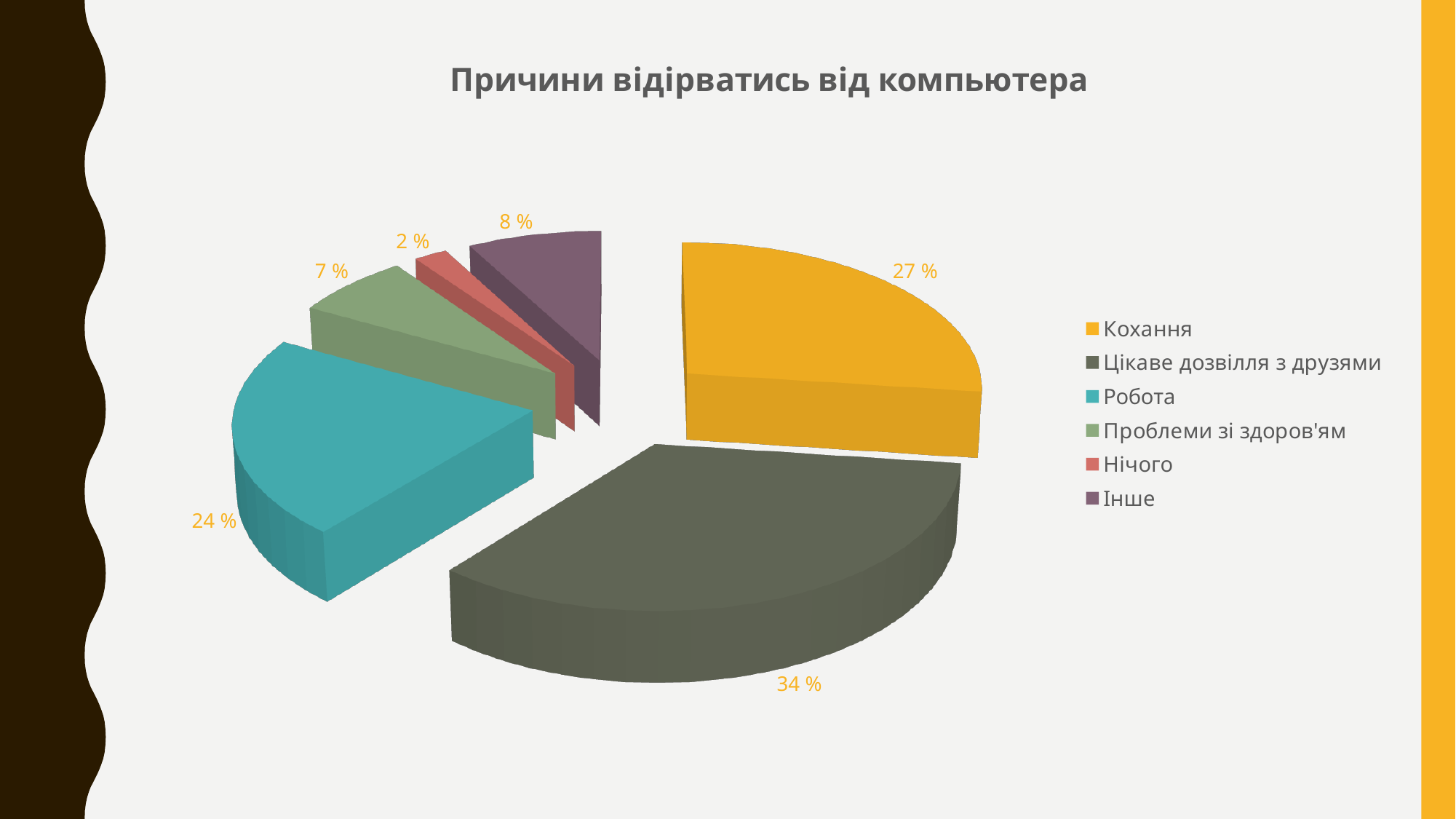
What is the title of the chart? Причини відірватись від компьютера What percentage is shown for Нічого? 2 % What percentage is shown for Робота? 24 % What percentage is shown for Кохання? 27 % What percentage is shown for Цікаве дозвілля з друзями? 34 % Which category has the smallest share of the pie? Нічого What percentage is shown for Проблеми зі здоров'ям? 7 % Which is larger, the share for Інше or the share for Проблеми зі здоров'ям? Інше What is the difference in percentage points between Цікаве дозвілля з друзями and Кохання? 7 What kind of chart is shown on the slide? pie chart How many categories does the legend list? 6 Which category has the largest share of the pie? Цікаве дозвілля з друзями